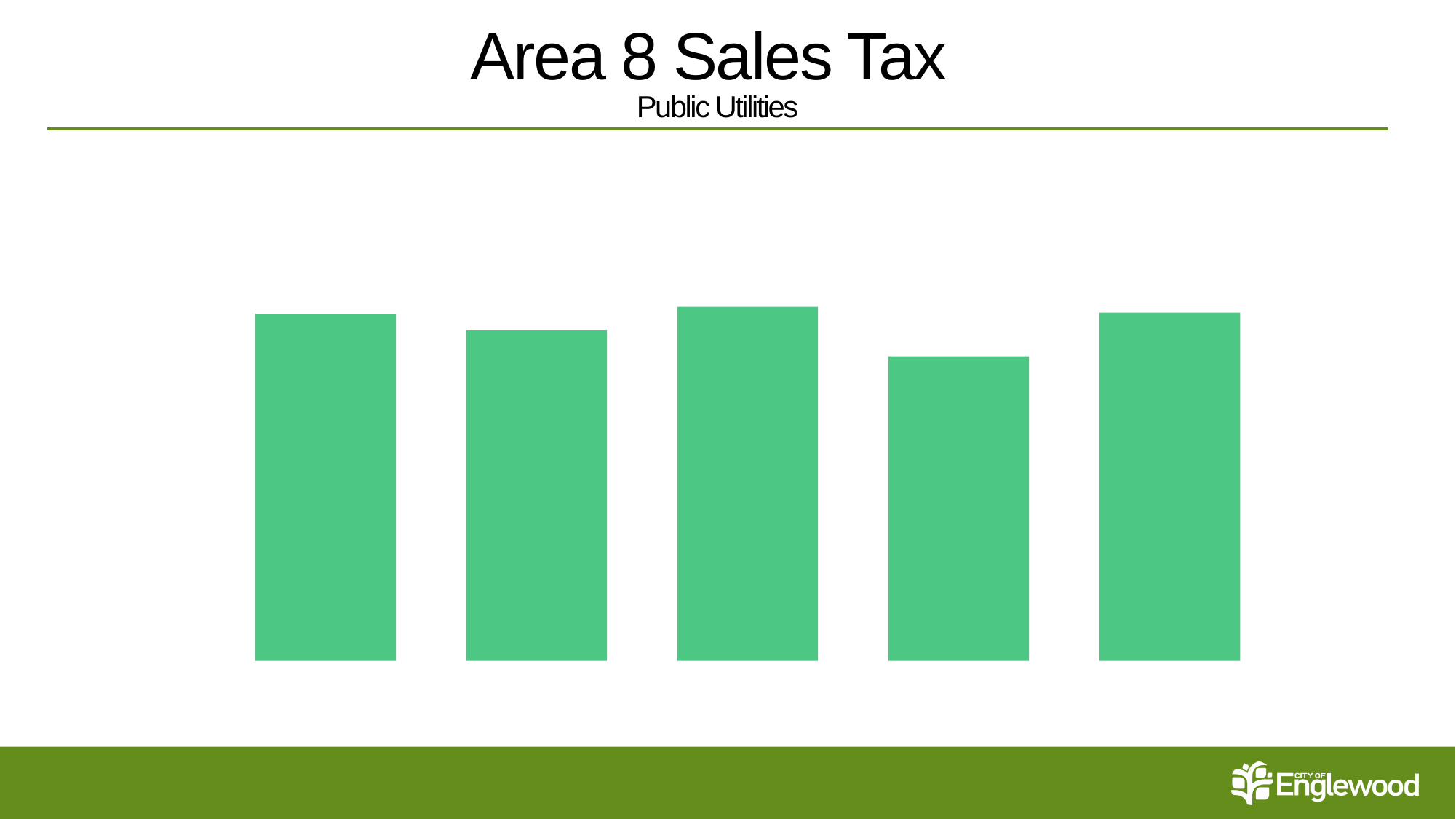
Is the second bar from the left taller or shorter than the first bar from the left? shorter Which bar is the tallest in the chart, counting from the left? the third bar Is the third bar from the left taller or shorter than the fourth bar from the left? taller What subtitle appears under the slide title? Public Utilities What kind of chart is shown on the slide? bar chart What is the title of the slide containing the chart? Area 8 Sales Tax Which bar is the shortest in the chart, counting from the left? the fourth bar How many bars are plotted in the chart? 5